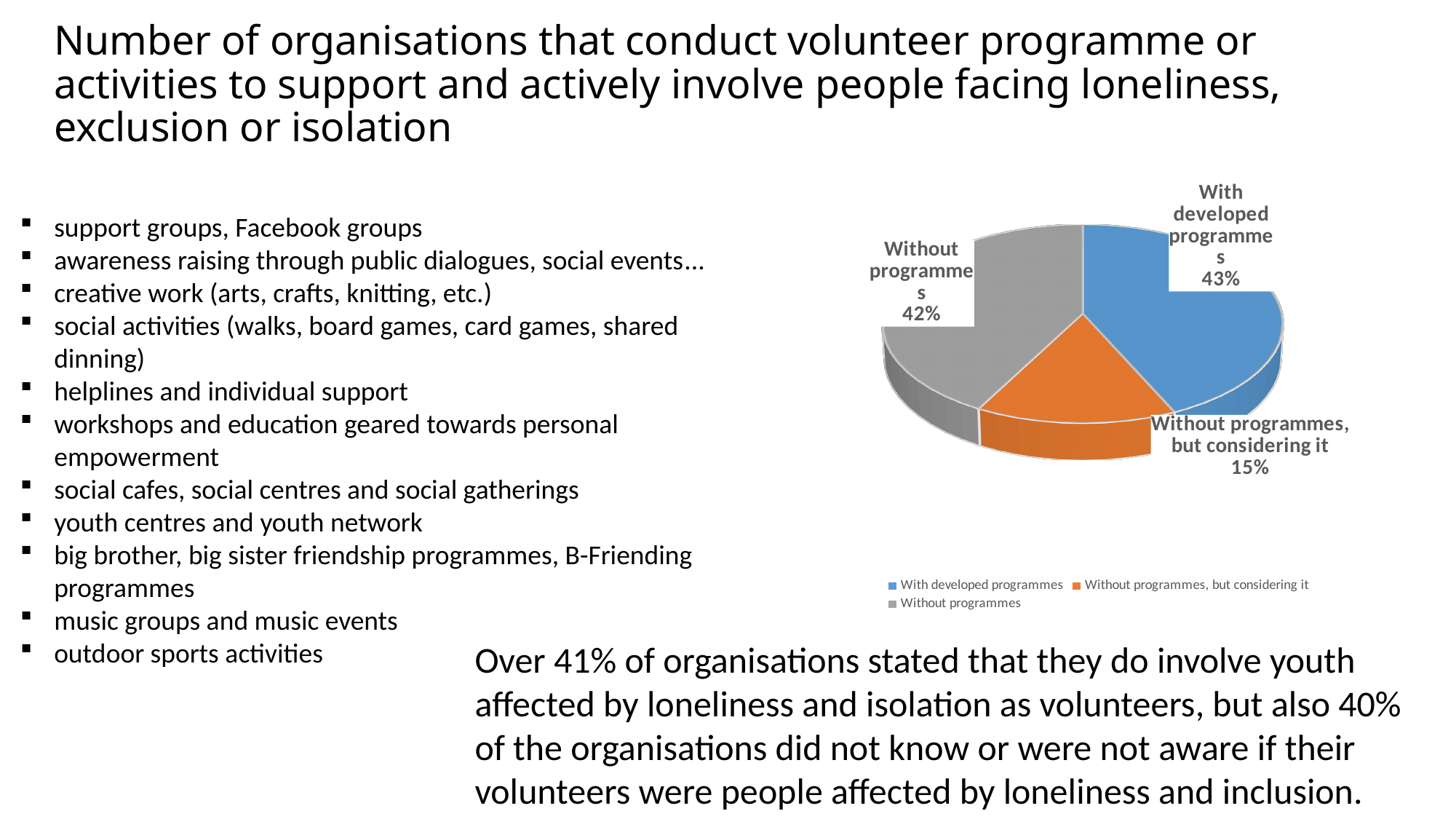
What share of the pie chart is labelled 'Without programmes'? 42% How many slices does the pie chart have? 3 How many percentage points larger is the 'With developed programmes' slice than the 'Without programmes, but considering it' slice? 28 percentage points What share of organisations have developed programmes according to the pie chart? 43% What percentage of organisations are without programmes but considering it? 15% What colour is the 'Without programmes, but considering it' slice? Orange Which category has the largest slice in the pie chart? With developed programmes Which category has the smallest slice in the pie chart? Without programmes, but considering it Which is larger: the share with developed programmes or the share without programmes but considering it? With developed programmes How many entries does the chart legend list? 3 How many percentage points separate the 'Without programmes' slice from the 'Without programmes, but considering it' slice? 27 percentage points What kind of chart is shown on the slide? Pie chart